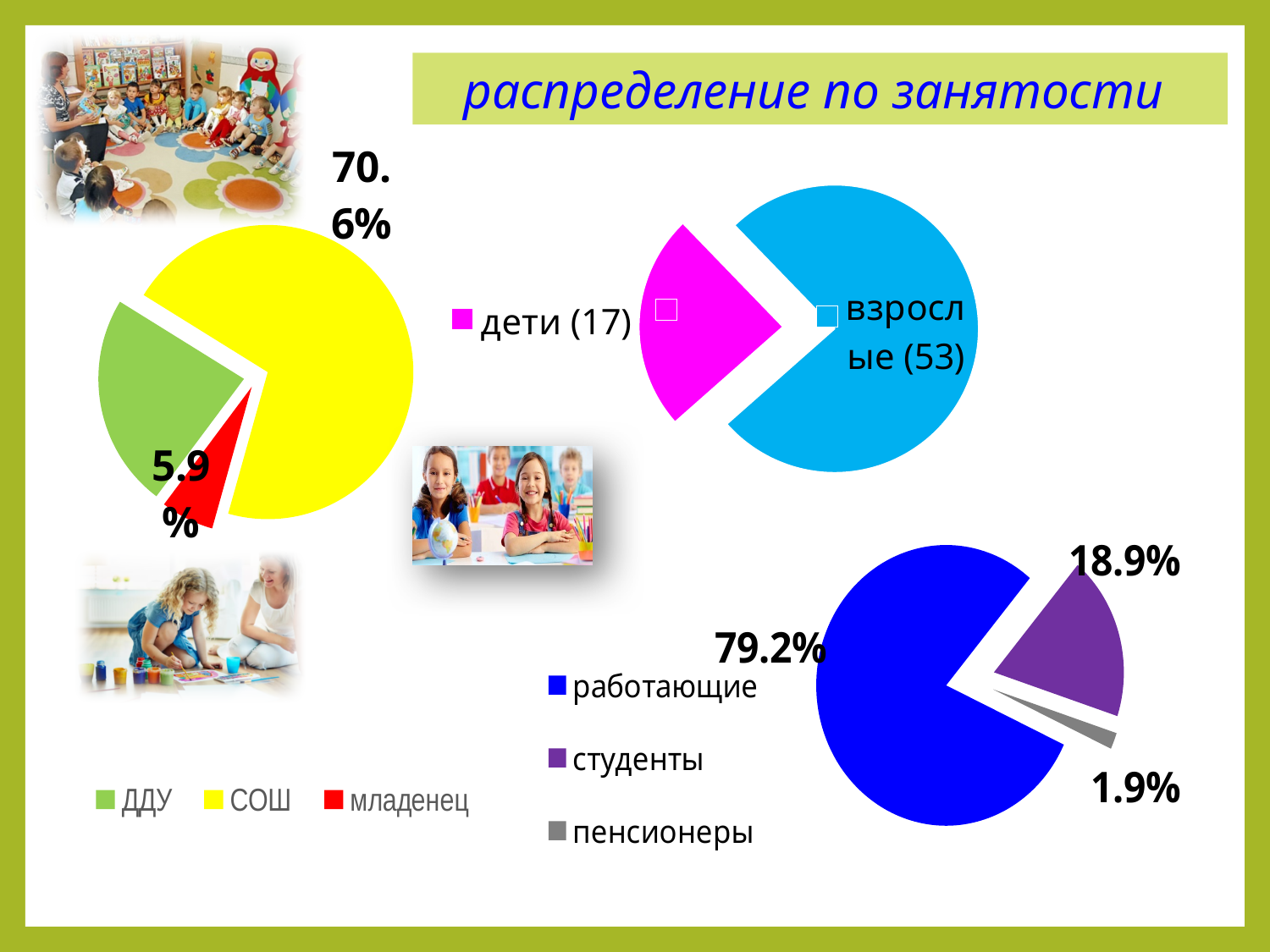
What type of chart is the top-middle chart showing дети and взрослые? pie chart In the top-middle pie chart, which group is larger, дети or взрослые? взрослые In the bottom-right pie chart, what is the value for работающие? 79.2% In the bottom-left pie chart (ДДУ, СОШ, младенец), what is the value for СОШ? 70.6% In the bottom-left pie chart (ДДУ, СОШ, младенец), what is the value for младенец? 5.9% In the bottom-right pie chart, which category has the largest share? работающие How many categories does the bottom-right pie chart show? 3 In the bottom-right pie chart, what is the value for студенты? 18.9% In the bottom-right pie chart, how many percentage points larger is работающие than студенты? 60.3 In the bottom-left pie chart (ДДУ, СОШ, младенец), which category has the largest share? СОШ In the bottom-right pie chart, what is the value for пенсионеры? 1.9% In the bottom-right pie chart, which category has the smallest share? пенсионеры